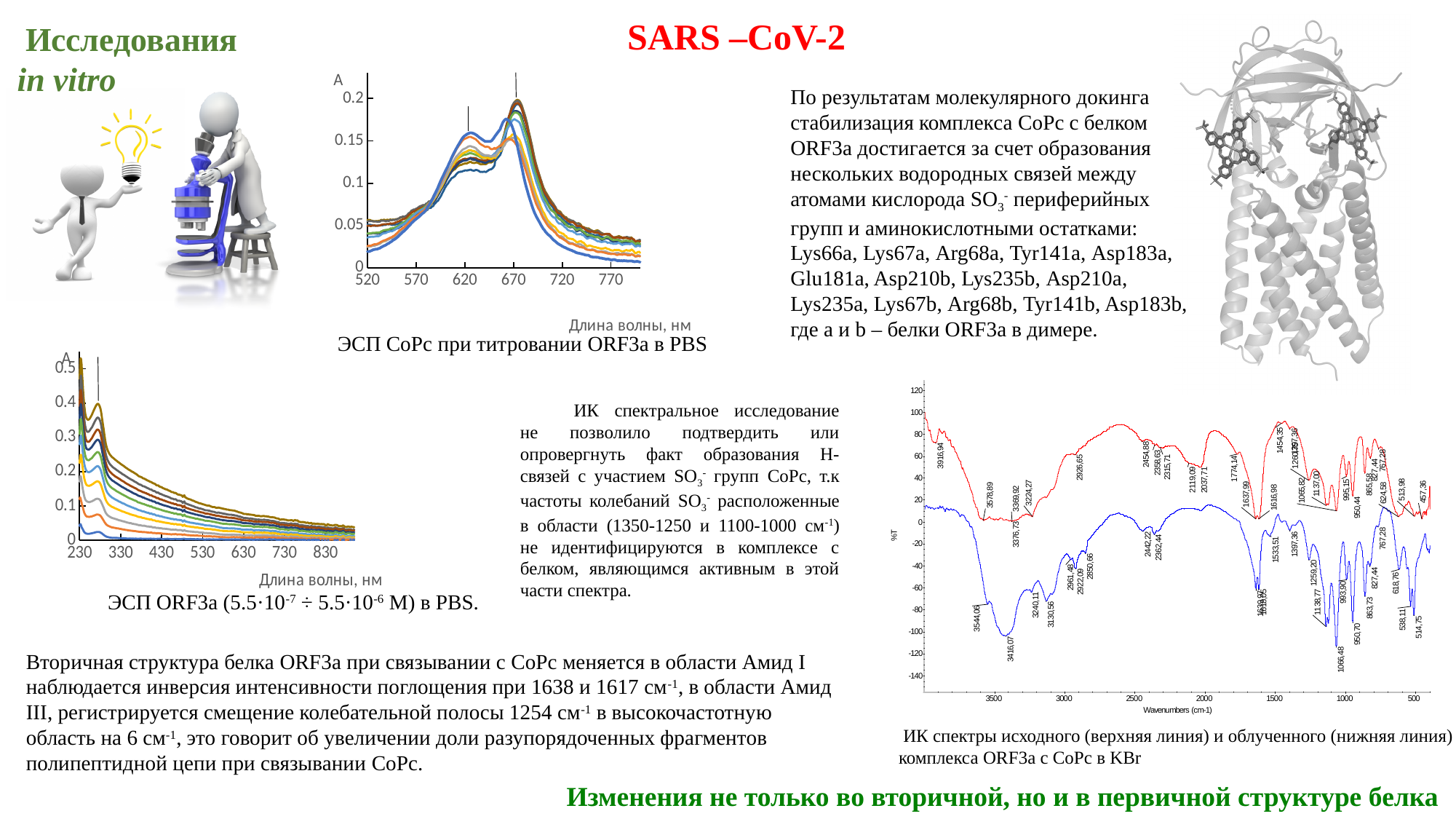
In the bottom-right IR spectrum chart, what is the label of the y axis? %T What kind of chart is the top chart titled "ЭСП CoPc при титровании ORF3a в PBS"? line chart In the bottom-left chart "ЭСП ORF3a в PBS", is the absorbance at 830 nm greater or less than 0.1? less In the bottom-right IR spectrum chart, how many spectra (lines) are plotted? 2 In the bottom-right IR spectrum chart, what is the label of the x axis? Wavenumbers (cm-1) In the top chart "ЭСП CoPc при титровании ORF3a в PBS", what is the label of the x axis? Длина волны, нм In the top chart "ЭСП CoPc при титровании ORF3a в PBS", is the absorbance at the peak near 670 nm greater or less than 0.15? greater In the top chart "ЭСП CoPc при титровании ORF3a в PBS", is the absorbance at 520 nm greater or less than 0.1? less In the bottom-left chart "ЭСП ORF3a в PBS", do the absorbance values rise or fall as wavelength increases from 230 nm to 830 nm? fall How many charts are shown on the slide? 3